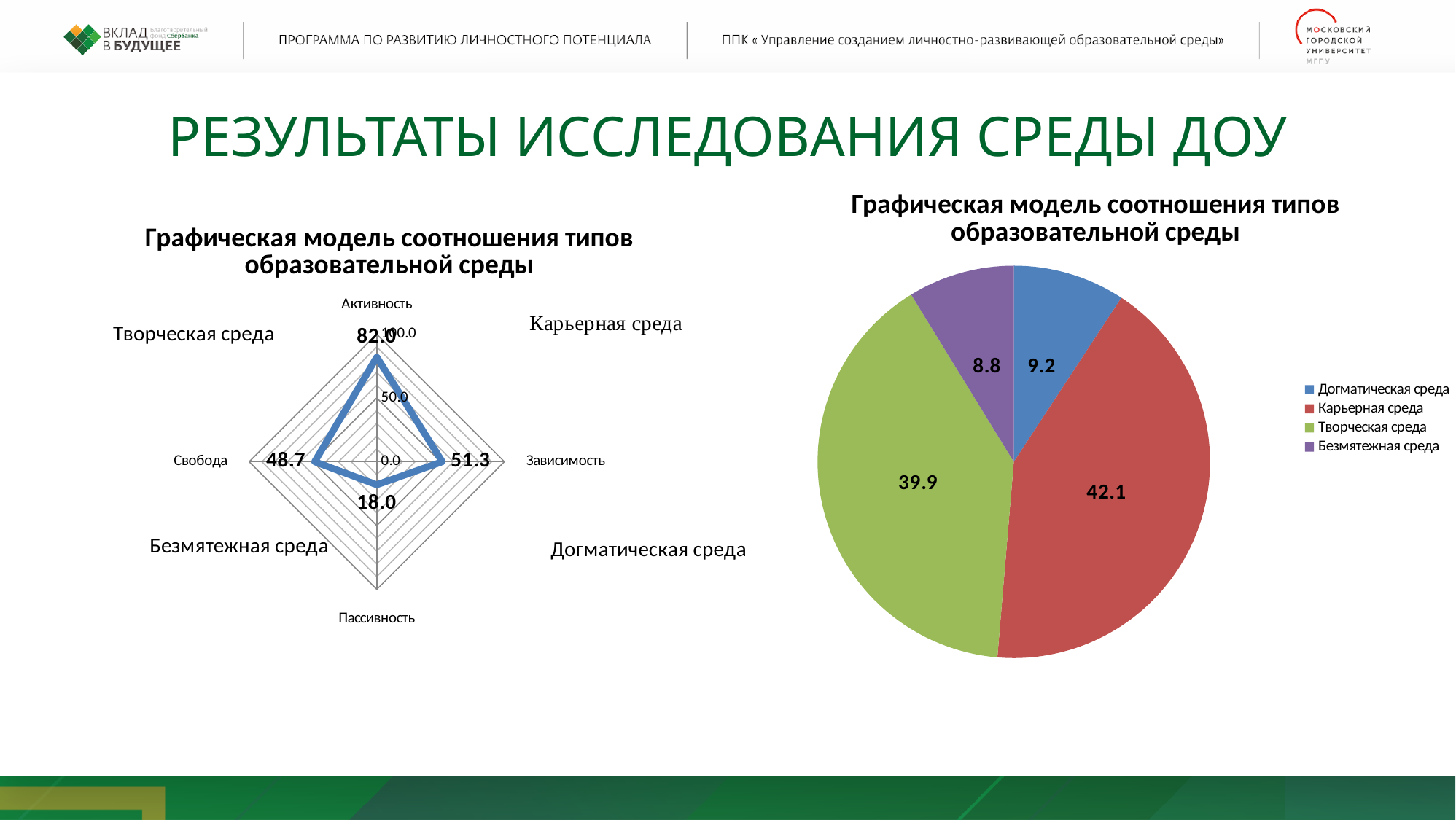
On the left chart, which axis has the highest value? Активность On the left chart, what is the value for Активность? 82.0 On the left chart, is the value for Активность greater or less than 50.0? greater On the right pie chart, which category has the largest slice? Карьерная среда What kind of chart is the left chart? radar chart On the left chart, what is the value for Пассивность? 18.0 On the right pie chart, what is the value for Карьерная среда? 42.1 How many categories does the legend of the right pie chart list? 4 On the left chart, which axis has the lowest value? Пассивность On the right pie chart, what is the difference between the values for Карьерная среда and Творческая среда? 2.2 On the left chart, what is the difference between the values for Зависимость and Свобода? 2.6 On the right pie chart, which category has the smallest slice? Безмятежная среда